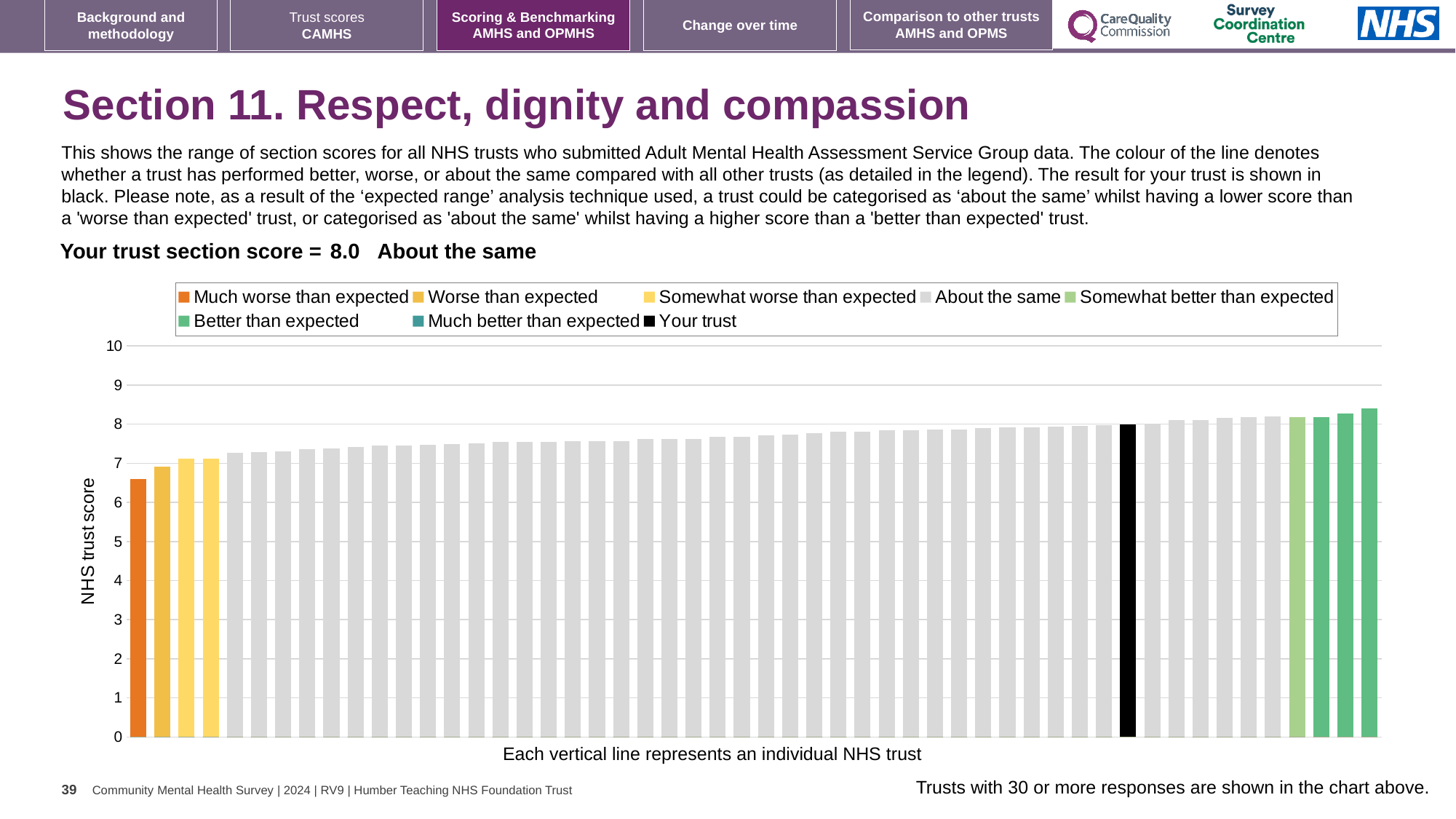
Which legend category does the tallest bar in the chart belong to? Better than expected How many bars are coloured as 'Better than expected'? 3 Is the value of the tallest bar in the chart greater or less than 8? greater What is the section score for your trust shown on the slide? 8.0 Is the value of the orange 'Much worse than expected' bar greater or less than 7? less How many entries does the chart legend list? 8 What is the label on the vertical axis of the chart? NHS trust score What kind of chart is shown on the slide? bar chart Is the value of the black 'Your trust' bar greater or less than 7? greater Is the 'Your trust' bar taller or shorter than the orange 'Much worse than expected' bar? taller Which category is your trust placed in according to the slide? About the same Which legend category does the shortest bar in the chart belong to? Much worse than expected